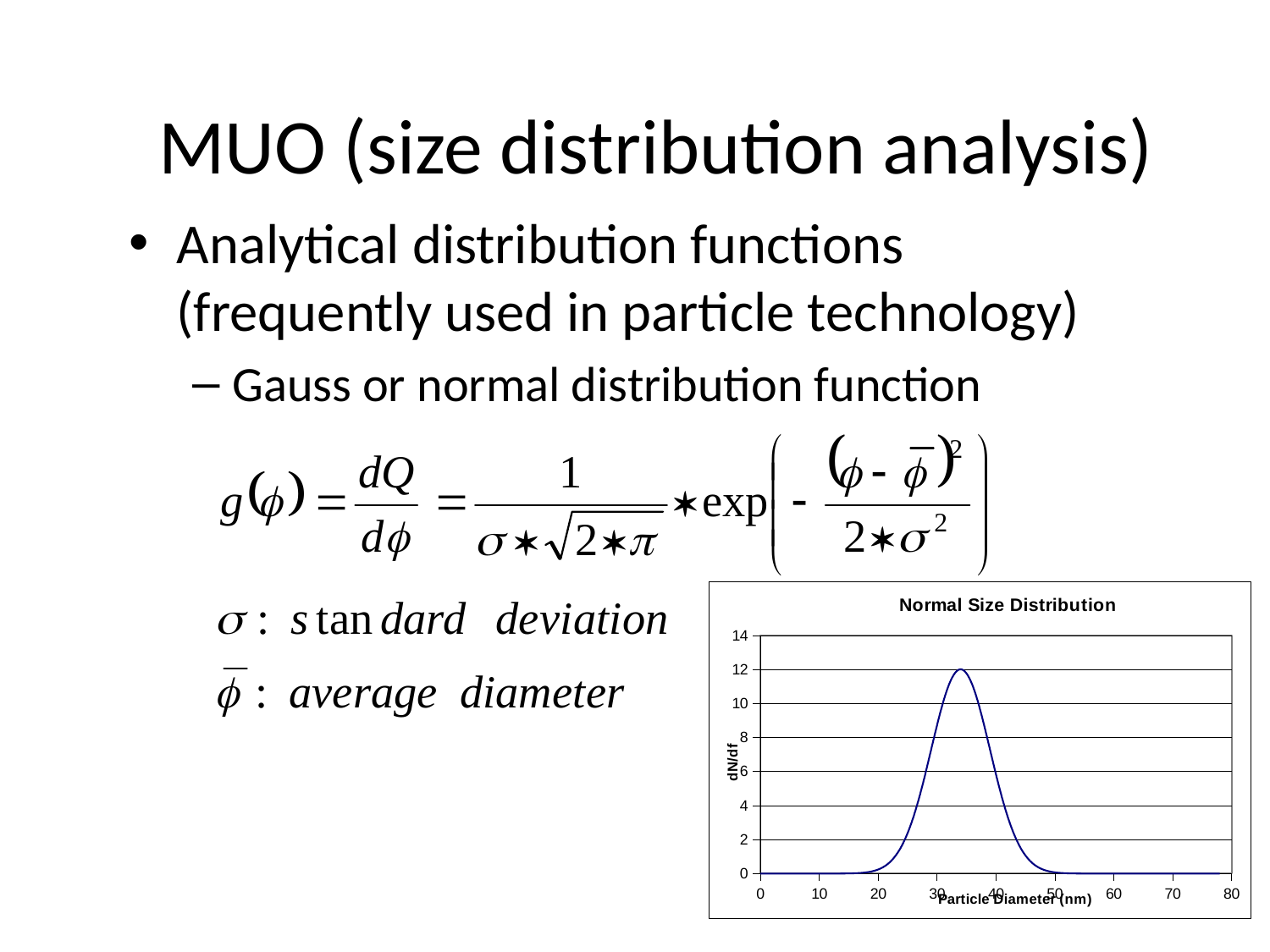
In the 'Normal Size Distribution' chart, is the peak value of the curve greater or less than 10? greater In the 'Normal Size Distribution' chart, is the peak of the curve located at a particle diameter greater or less than 40 nm? less What is the highest value shown on the x axis of the 'Normal Size Distribution' chart? 80 In the 'Normal Size Distribution' chart, is the value at a particle diameter of 10 nm greater or less than 2? less In the 'Normal Size Distribution' chart, does the curve rise or fall as particle diameter increases from 20 nm to 30 nm? rise What is the highest value shown on the y axis of the 'Normal Size Distribution' chart? 14 What is the title of the chart on the slide? Normal Size Distribution What kind of chart is the 'Normal Size Distribution' chart? line chart In the 'Normal Size Distribution' chart, does the curve rise or fall as particle diameter increases from 40 nm to 50 nm? fall What is the label of the x axis of the 'Normal Size Distribution' chart? Particle Diameter (nm)